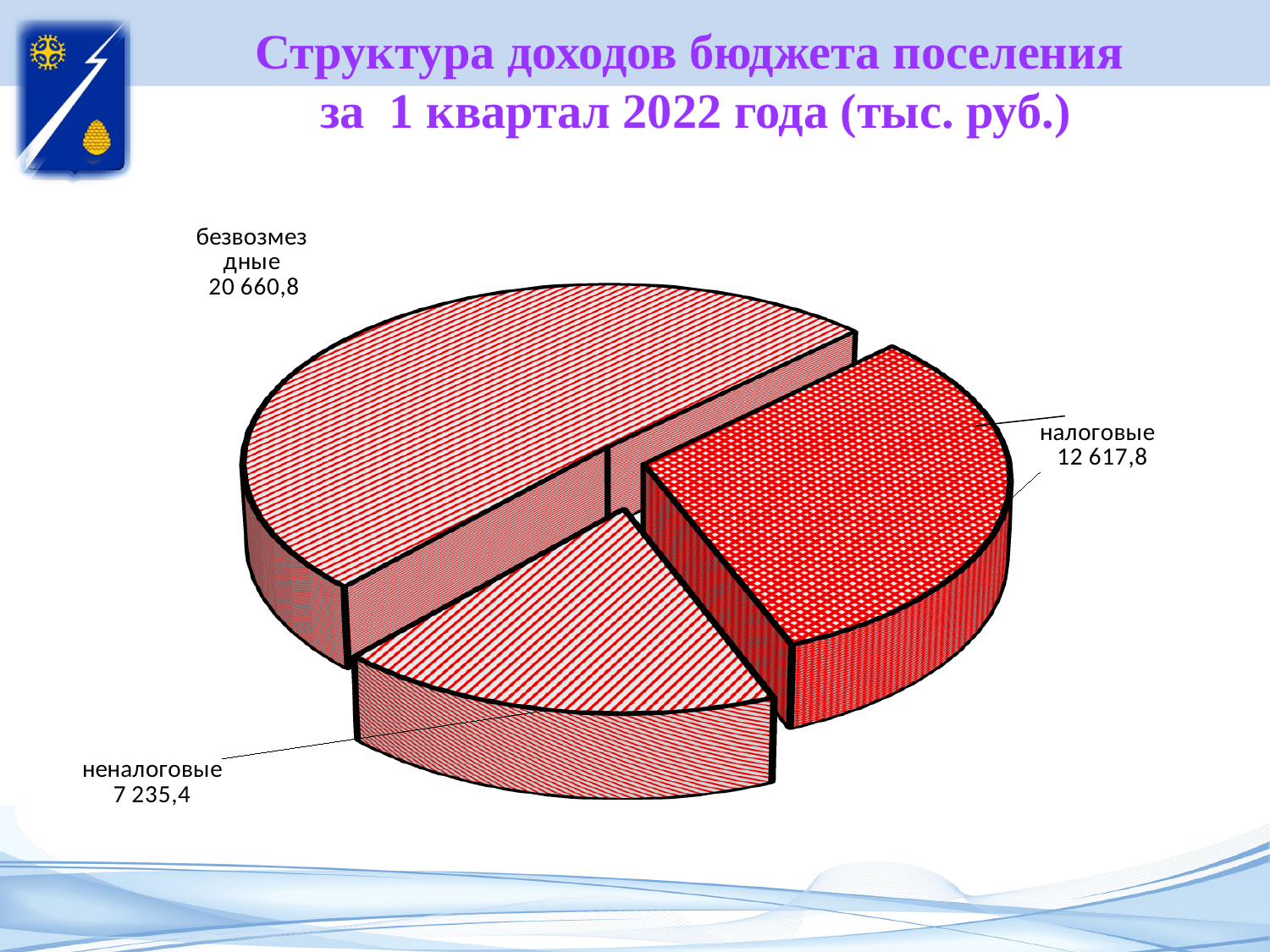
Which category has the largest slice of the pie? безвозмездные What is the value for неналоговые on the pie chart? 7 235,4 Which category has the smallest slice of the pie? неналоговые What is the total of all three slices of the pie chart? 40 514,0 Which is larger, налоговые or неналоговые? налоговые How many slices does the pie chart have? 3 What is the value for налоговые on the pie chart? 12 617,8 What is the difference between the values for налоговые and неналоговые? 5 382,4 What is the value for безвозмездные on the pie chart? 20 660,8 What is the title of the chart on the slide? Структура доходов бюджета поселения за 1 квартал 2022 года (тыс. руб.) What is the difference between the values for безвозмездные and налоговые? 8 043,0 What kind of chart is shown on the slide? pie chart